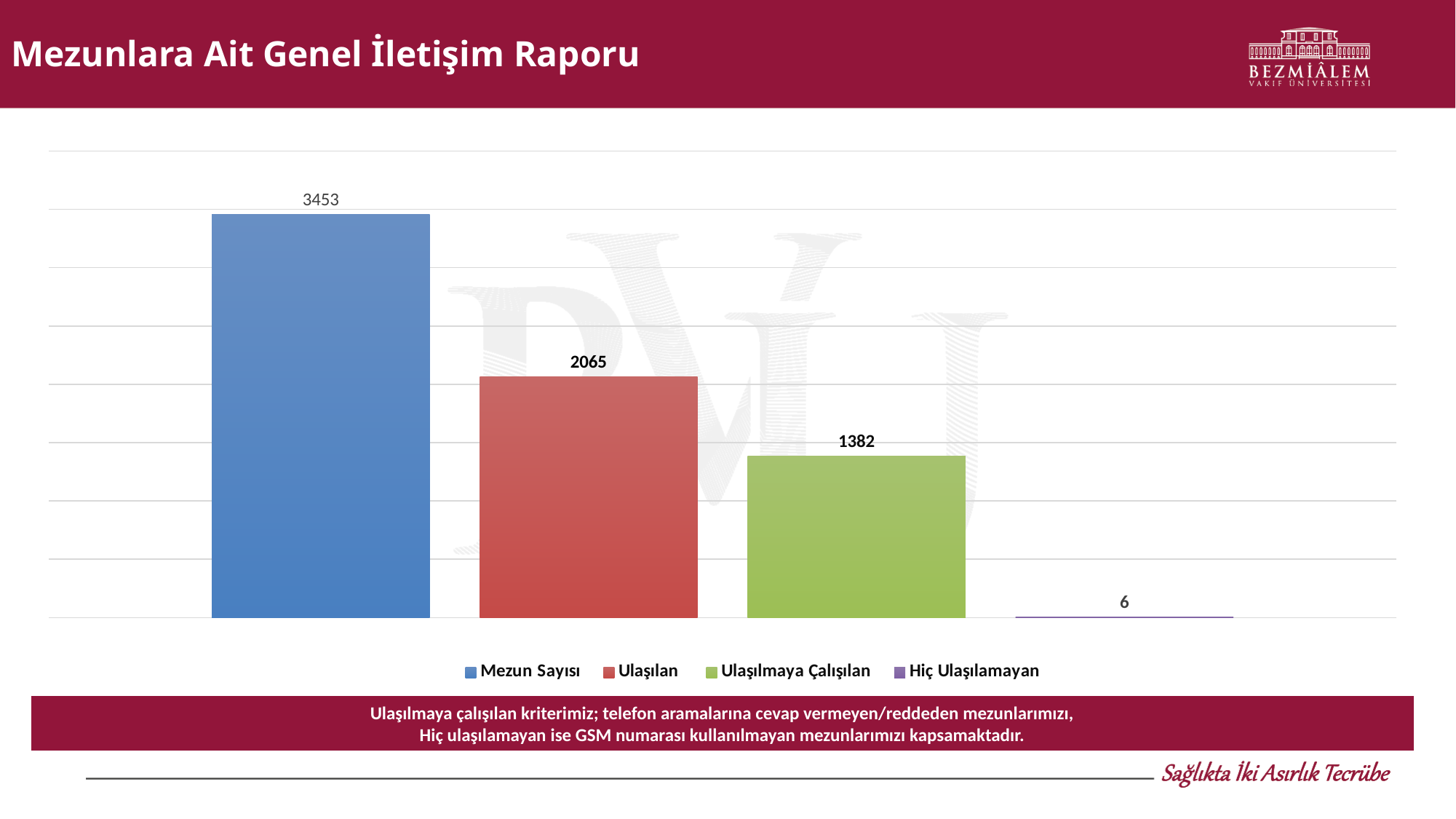
What colour is the bar for Ulaşılmaya Çalışılan? Green What is the value for Ulaşılmaya Çalışılan? 1382 Which is larger, Ulaşılan or Ulaşılmaya Çalışılan? Ulaşılan What is the value for Mezun Sayısı? 3453 What is the difference between Ulaşılan and Ulaşılmaya Çalışılan? 683 What kind of chart is shown on the slide? Bar chart How many series does the legend list? 4 Which series has the lowest value? Hiç Ulaşılamayan What is the value for Ulaşılan? 2065 What is the difference between Mezun Sayısı and Ulaşılan? 1388 What is the value for Hiç Ulaşılamayan? 6 Which series has the highest value? Mezun Sayısı